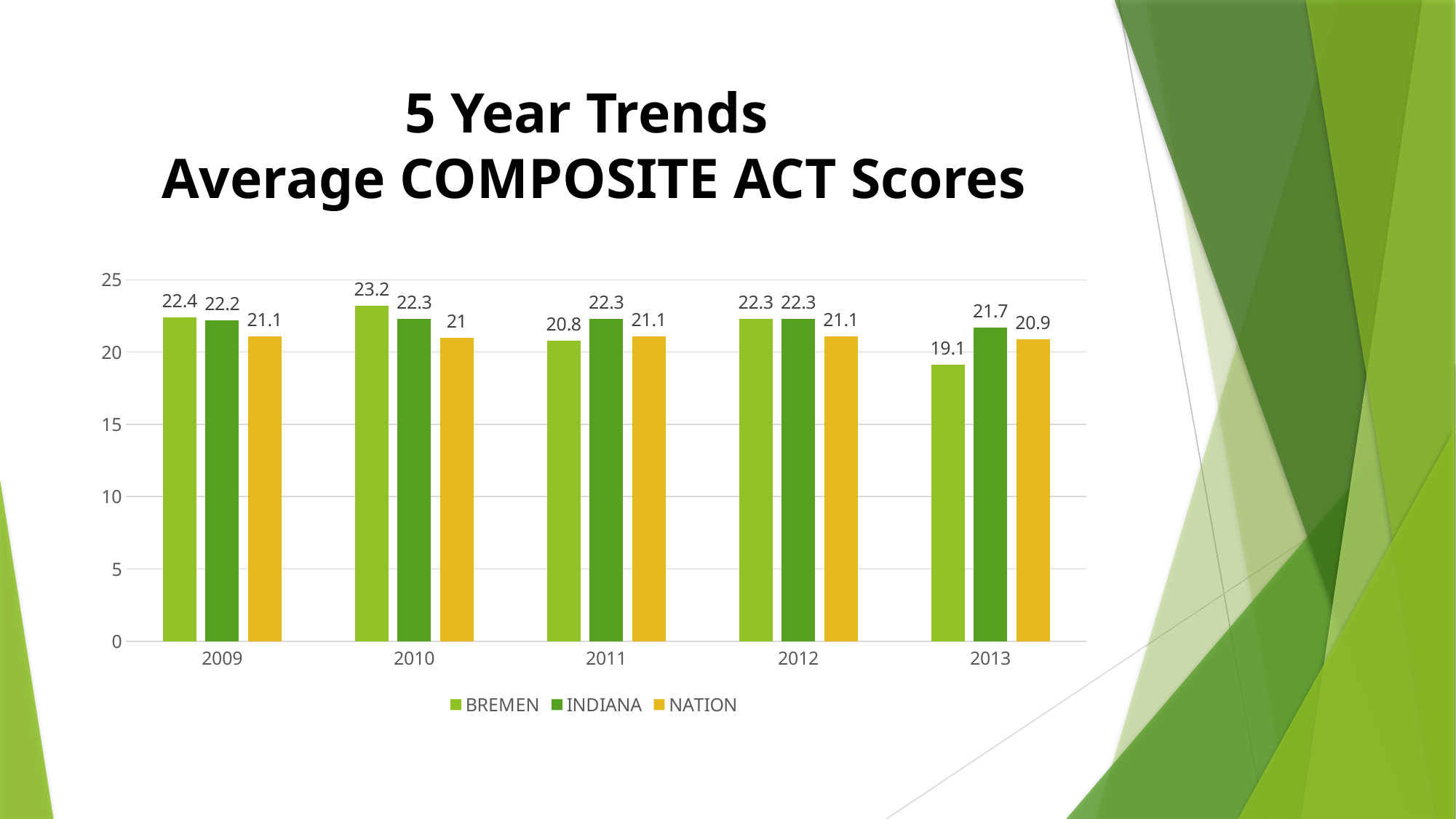
Is the BREMEN value for 2013 greater or less than 20? less In which year is the BREMEN score the lowest? 2013 In which year is the BREMEN score the highest? 2010 How many years are shown on the x axis? 5 What kind of chart is shown on the slide? bar chart What is the NATION average composite ACT score for 2013? 20.9 What is the difference between the INDIANA and BREMEN scores in 2013? 2.6 What is the BREMEN average composite ACT score for 2010? 23.2 What is the INDIANA average composite ACT score for 2009? 22.2 Which series is shown in yellow? NATION How many series does the legend list? 3 Which is larger in 2011, the BREMEN score or the NATION score? NATION